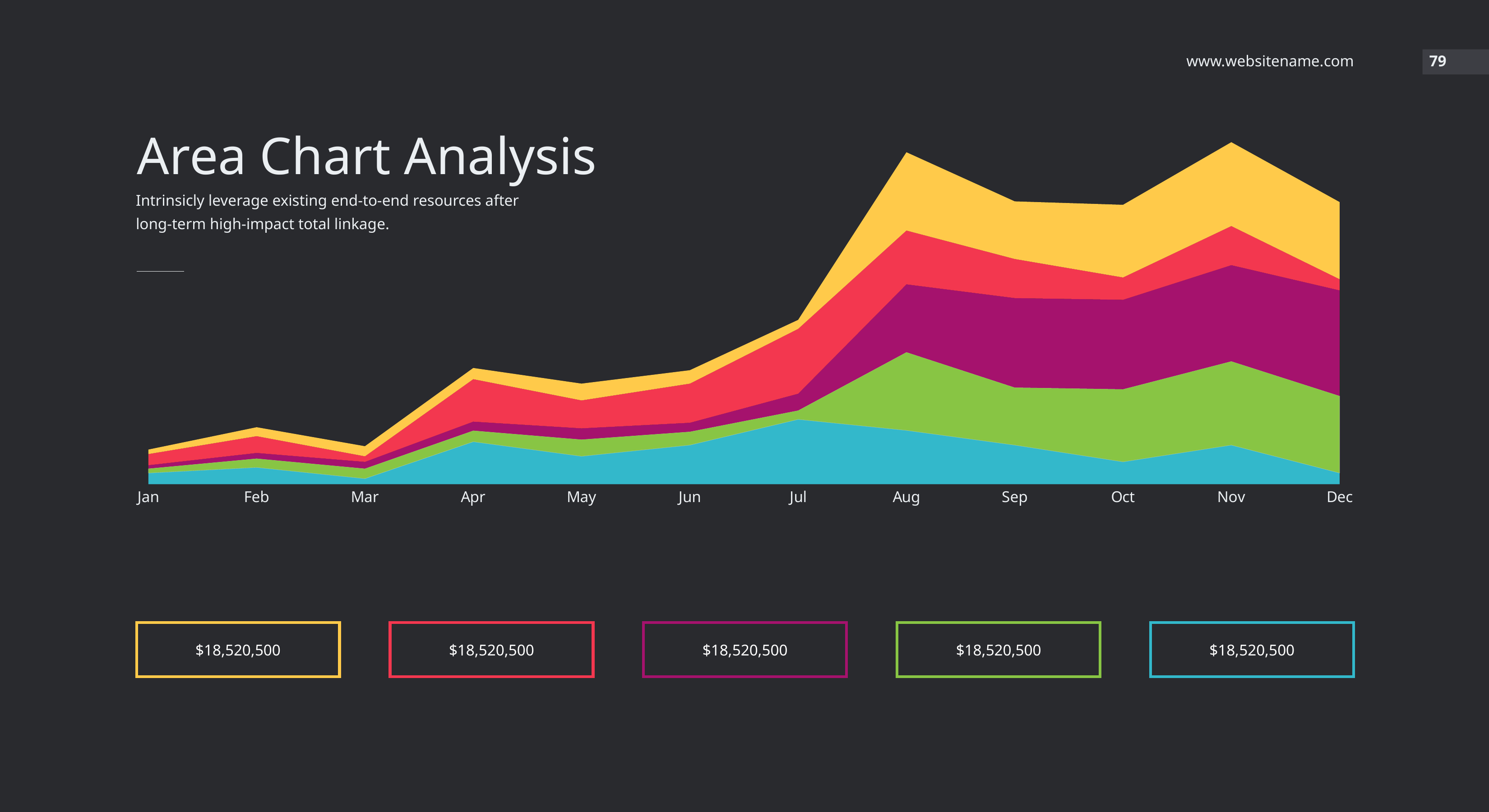
Which month is the first category on the x axis? Jan Does the blue series rise or fall from Mar to Jul? rise Is the total stacked value larger in Aug or in Apr? Aug Is the total stacked value larger in Jan or in Jul? Jul What kind of chart is shown on the slide? area chart Which month has the highest total stacked value in the chart? Nov Does the total stacked value generally rise or fall from Jan to Aug? rise In which month does the blue (bottom) series reach its highest value? Jul What is the title of the slide containing the chart? Area Chart Analysis What value is printed in the yellow-outlined box below the chart? $18,520,500 How many coloured series are stacked in the area chart? 5 How many months are shown along the x axis of the chart? 12